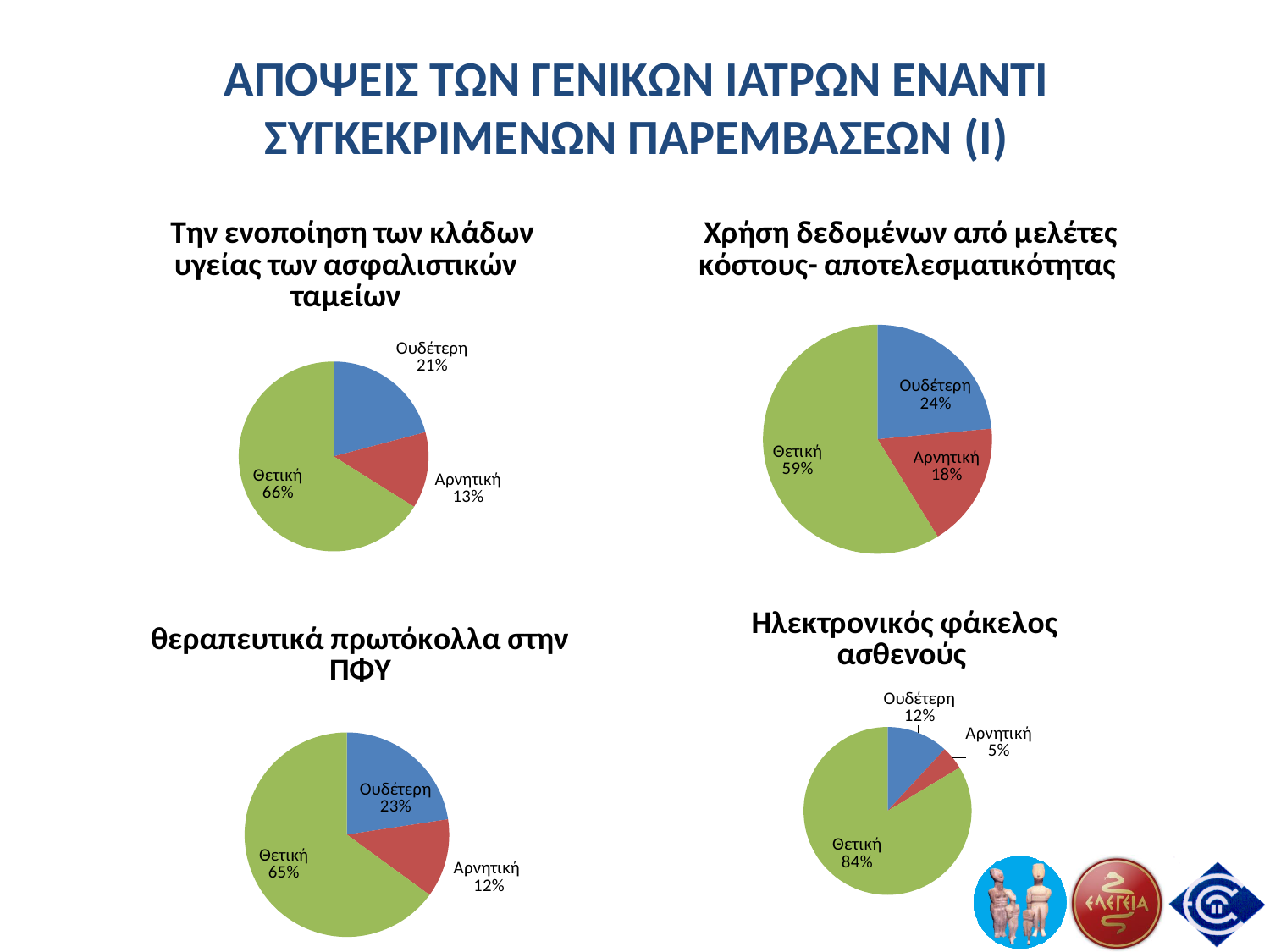
In the top-right chart (Χρήση δεδομένων από μελέτες κόστους- αποτελεσματικότητας), what is the difference between the Ουδέτερη and Αρνητική shares? 6% In the bottom-right chart (Ηλεκτρονικός φάκελος ασθενούς), what share is labelled Αρνητική? 5% In the top-right chart (Χρήση δεδομένων από μελέτες κόστους- αποτελεσματικότητας), what share is labelled Ουδέτερη? 24% In the top-right chart (Χρήση δεδομένων από μελέτες κόστους- αποτελεσματικότητας), which slice is the largest? Θετική In the bottom-right chart (Ηλεκτρονικός φάκελος ασθενούς), which is larger, the Ουδέτερη slice or the Αρνητική slice? Ουδέτερη In the bottom-left chart (θεραπευτικά πρωτόκολλα στην ΠΦΥ), which slice is the smallest? Αρνητική In the bottom-right chart (Ηλεκτρονικός φάκελος ασθενούς), what share is labelled Θετική? 84% In the top-left chart (Την ενοποίηση των κλάδων υγείας των ασφαλιστικών ταμείων), what share is labelled Αρνητική? 13% How many slices does the top-left chart (Την ενοποίηση των κλάδων υγείας των ασφαλιστικών ταμείων) have? 3 In the top-left chart (Την ενοποίηση των κλάδων υγείας των ασφαλιστικών ταμείων), what share is labelled Θετική? 66% What type of chart is the bottom-left chart (θεραπευτικά πρωτόκολλα στην ΠΦΥ)? Pie chart In the bottom-left chart (θεραπευτικά πρωτόκολλα στην ΠΦΥ), what share is labelled Ουδέτερη? 23%